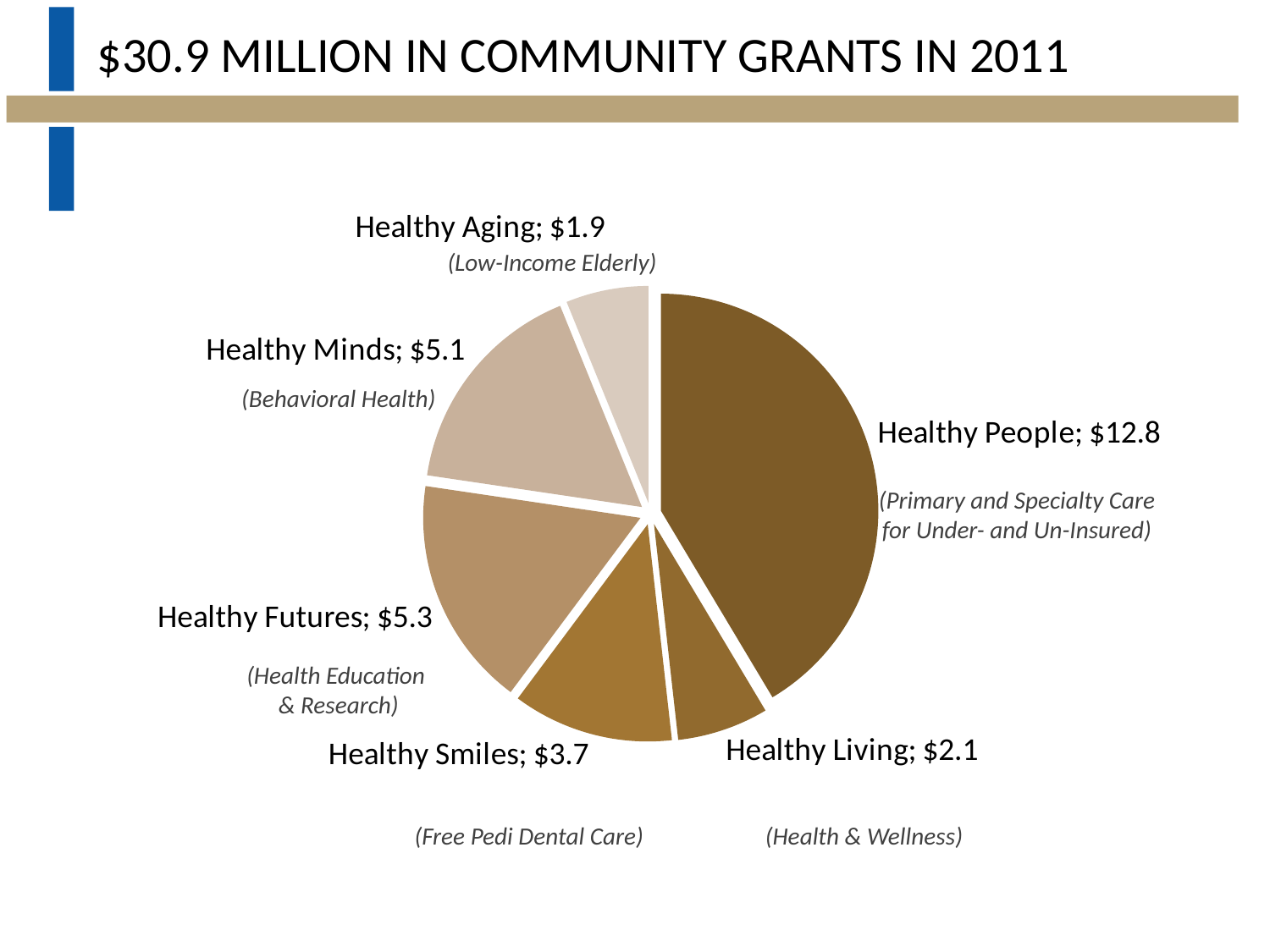
Which category has the smallest slice of the pie? Healthy Aging What is the difference between the values for Healthy People and Healthy Futures? $7.5 What is the difference between the values for Healthy Living and Healthy Aging? $0.2 What is the value shown for Healthy People? $12.8 What is the value shown for Healthy Minds? $5.1 Which category has the largest slice of the pie? Healthy People What type of chart is shown on the slide? Pie chart What is the value shown for Healthy Smiles? $3.7 What is the total of all the slice values in the pie chart? $30.9 How many slices does the pie chart have? 6 What description is given in parentheses under the Healthy Smiles label? (Free Pedi Dental Care) Which is larger, Healthy Futures or Healthy Minds? Healthy Futures